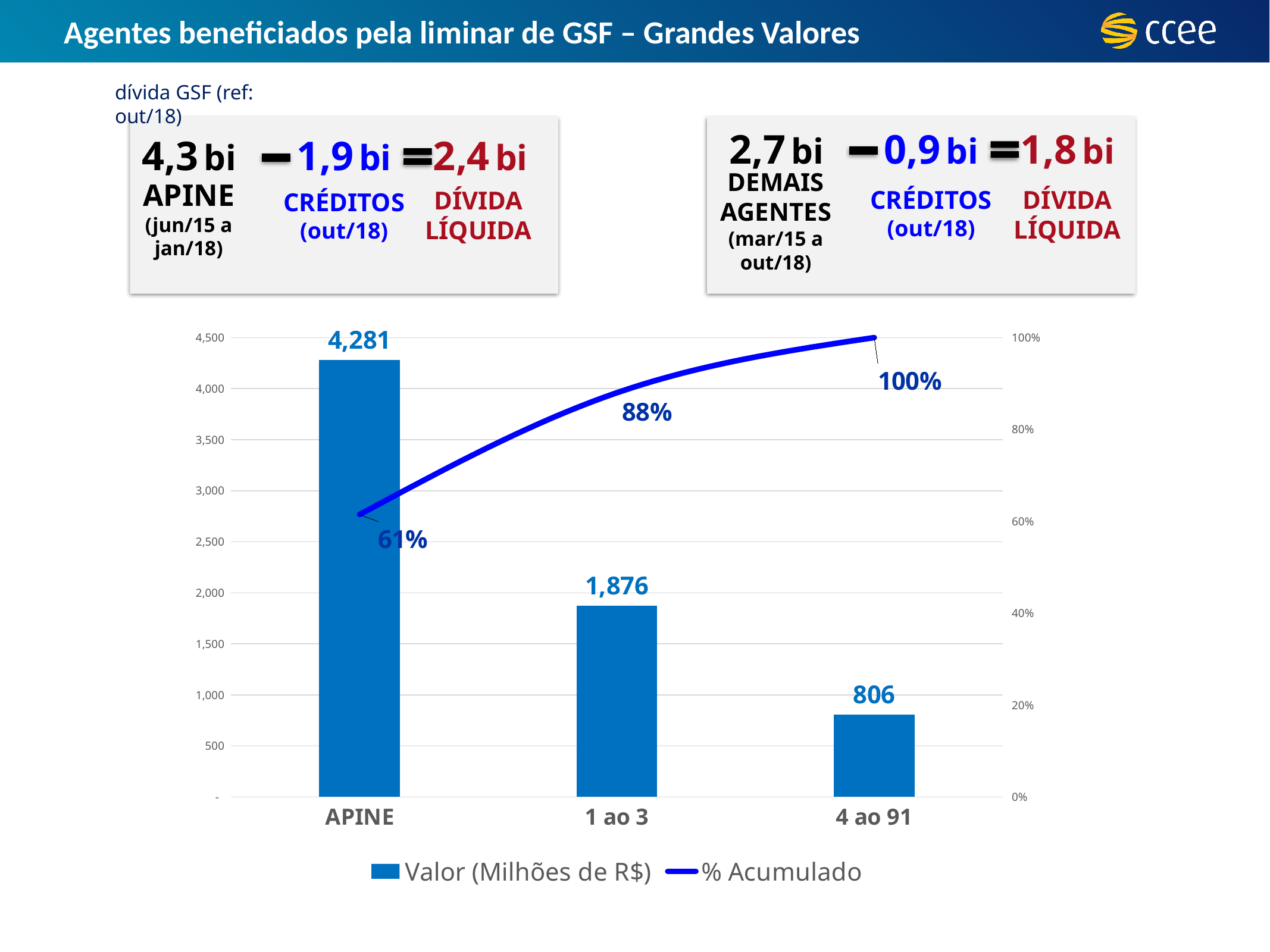
Which category has the highest value (Milhões de R$)? APINE What is the value (Milhões de R$) for APINE? 4,281 Which category has the lowest value (Milhões de R$)? 4 ao 91 How many categories are shown on the x axis of the chart? 3 What is the difference between the value for APINE and the value for 1 ao 3? 2,405 Which is larger, the value for 1 ao 3 or the value for 4 ao 91? 1 ao 3 What is the value (Milhões de R$) for the category 1 ao 3? 1,876 Does the % Acumulado line rise or fall from APINE to 4 ao 91? rise How many series does the chart legend list? 2 What is the % Acumulado value at the category 1 ao 3? 88% What is the % Acumulado value at APINE? 61% What is the value (Milhões de R$) for the category 4 ao 91? 806